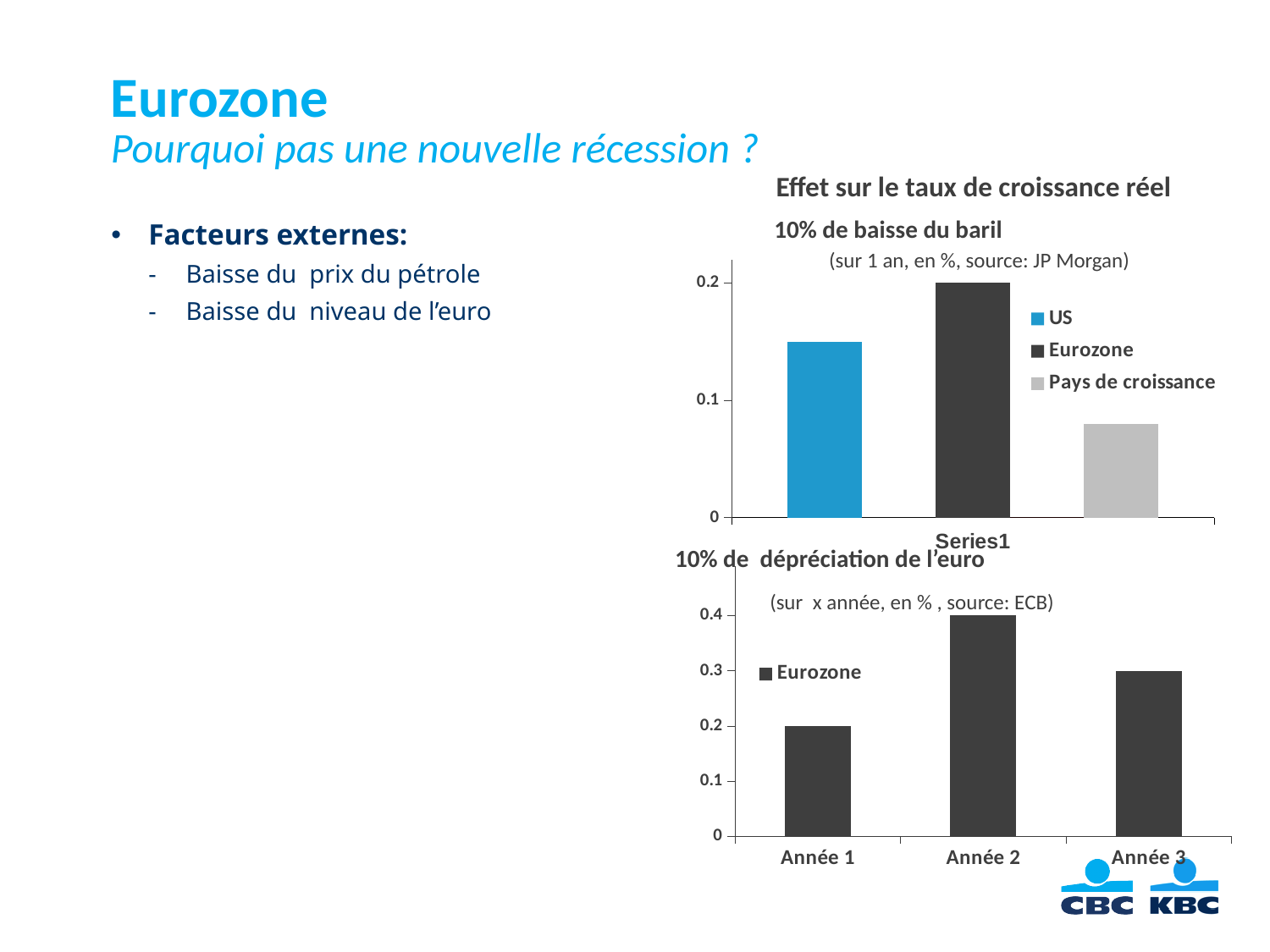
In the bottom chart (10% de dépréciation de l'euro), what is the value for Année 2? 0.4 In the top chart (10% de baisse du baril), what kind of chart is shown? bar chart In the bottom chart (10% de dépréciation de l'euro), what is the difference between the values for Année 2 and Année 1? 0.2 In the top chart (10% de baisse du baril), how many series does the legend list? 3 In the top chart (10% de baisse du baril), what is the value for Eurozone? 0.2 In the bottom chart (10% de dépréciation de l'euro), how many categories are shown on the x axis? 3 In the top chart (10% de baisse du baril), is the value for Pays de croissance greater or less than 0.1? less In the top chart (10% de baisse du baril), is the value for US greater or less than 0.1? greater In the bottom chart (10% de dépréciation de l'euro), which year has the highest value? Année 2 In the bottom chart (10% de dépréciation de l'euro), what is the value for Année 1? 0.2 In the top chart (10% de baisse du baril), which series has the highest bar? Eurozone In the top chart (10% de baisse du baril), which series has the lowest bar? Pays de croissance